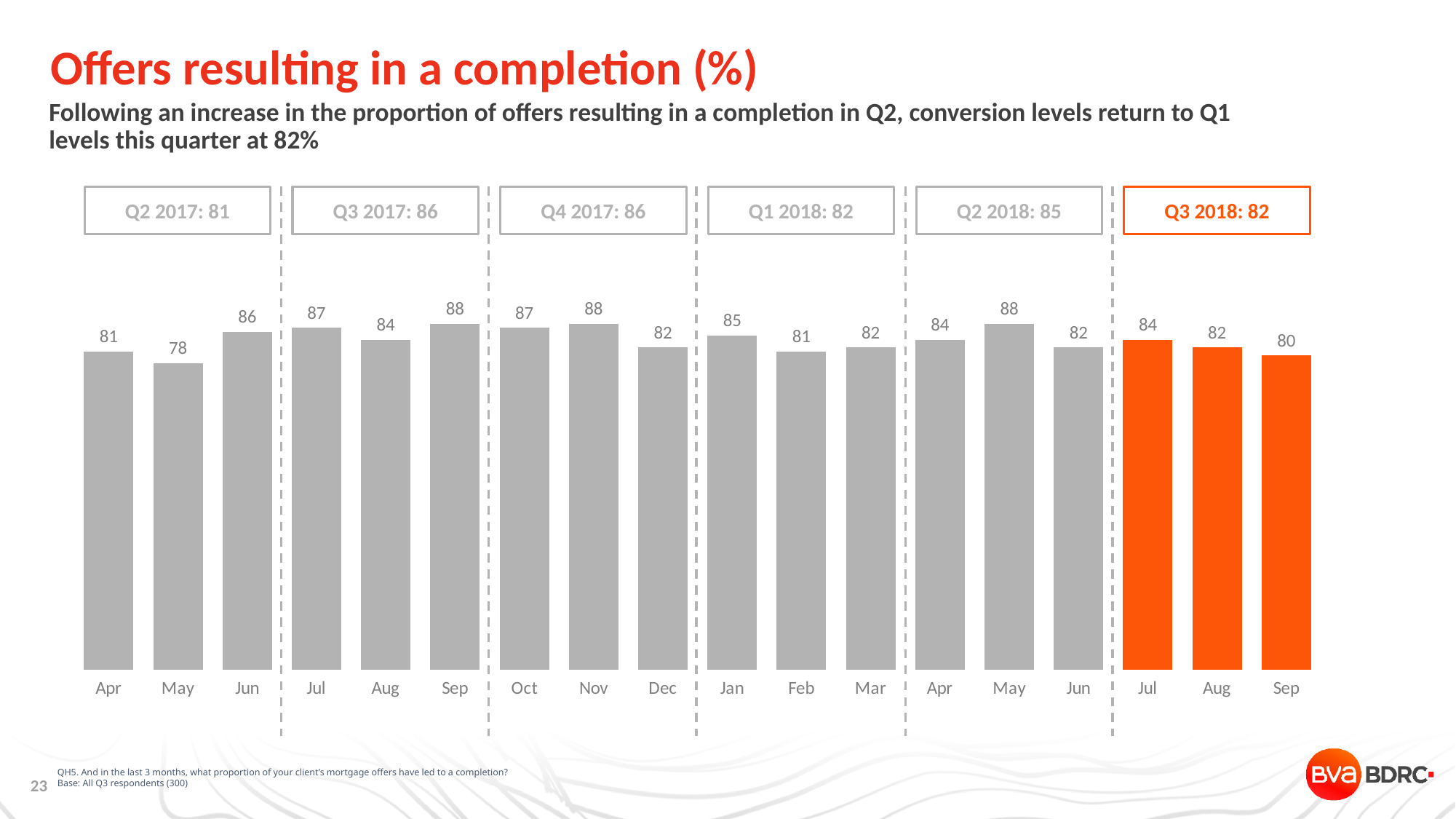
What is the value for May 2017 (the second bar, in the Q2 2017 section)? 78 Which is larger, the value for Jan 2018 or the value for Feb 2018? Jan 2018 What is the difference between the Jul 2018 value and the Sep 2018 value? 4 How many monthly bars are plotted in the chart? 18 Do the values rise or fall across the three months of the Q3 2018 section (Jul, Aug, Sep)? fall Which quarter's bars are highlighted in orange rather than grey? Q3 2018 What quarterly figure is shown in the box for Q2 2018? 85 What is the value for Dec in the Q4 2017 section? 82 Which month has the lowest value in the chart? May 2017 What is the value for Sep 2018 (the last bar, in the Q3 2018 section)? 80 What is the difference between the Q3 2017 quarterly figure and the Q1 2018 quarterly figure shown in the boxes? 4 What kind of chart is shown on the slide? bar chart